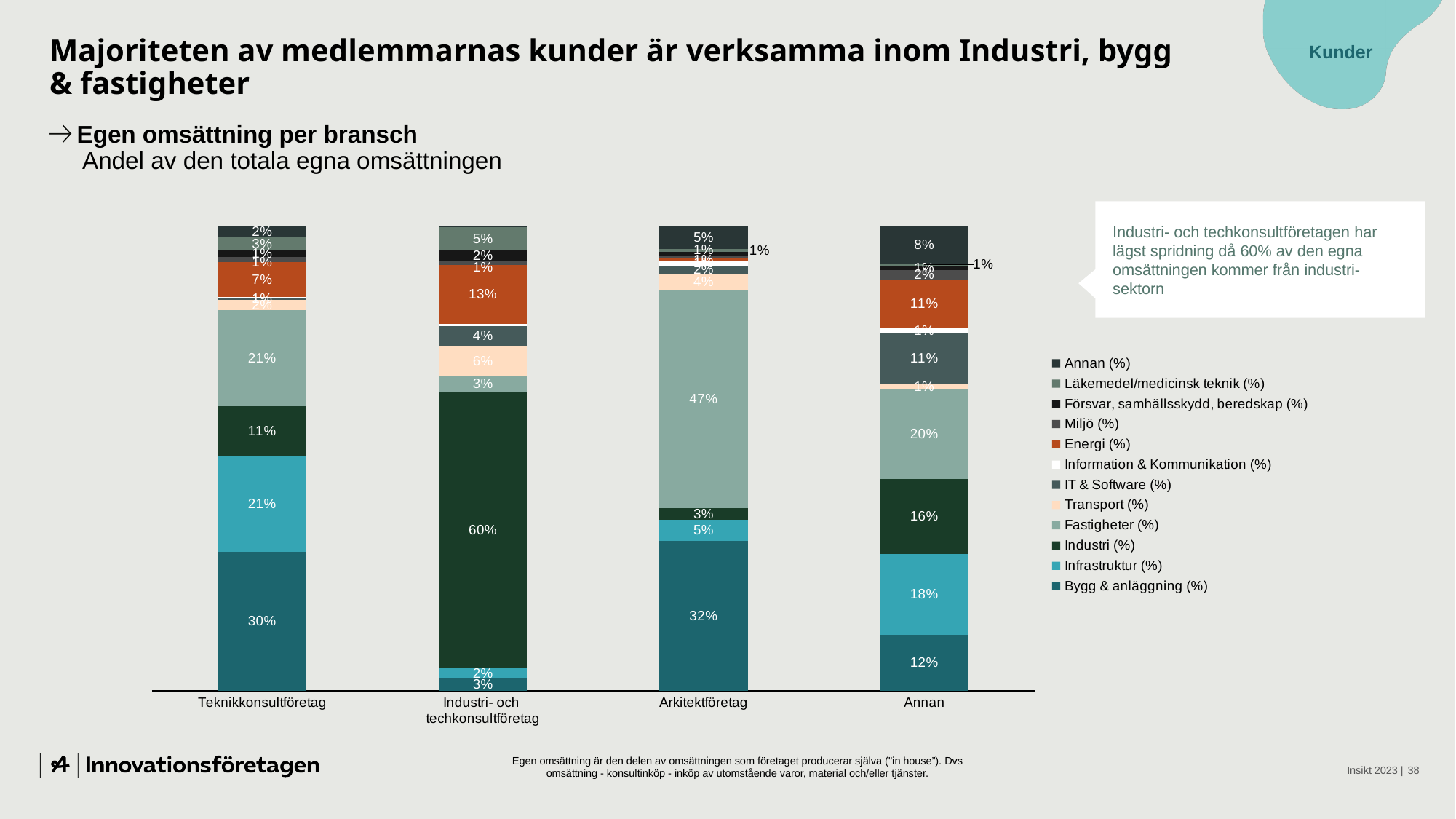
What is the Fastigheter (%) value for Arkitektföretag? 47% What is the Bygg & anläggning (%) value for Teknikkonsultföretag? 30% What is the Energi (%) value for Industri- och techkonsultföretag? 13% Which category has the highest Bygg & anläggning (%) value? Arkitektföretag Which is larger: the Fastigheter (%) value for Annan or for Teknikkonsultföretag? Teknikkonsultföretag How many categories are shown along the x axis of the chart? 4 What is the Industri (%) value for Industri- och techkonsultföretag? 60% How many series does the legend list? 12 Which category has the lowest Industri (%) value? Arkitektföretag What is the Infrastruktur (%) value for Annan? 18% What is the difference between the Bygg & anläggning (%) values for Arkitektföretag and Teknikkonsultföretag? 2% What type of chart is shown on the slide? Stacked bar chart